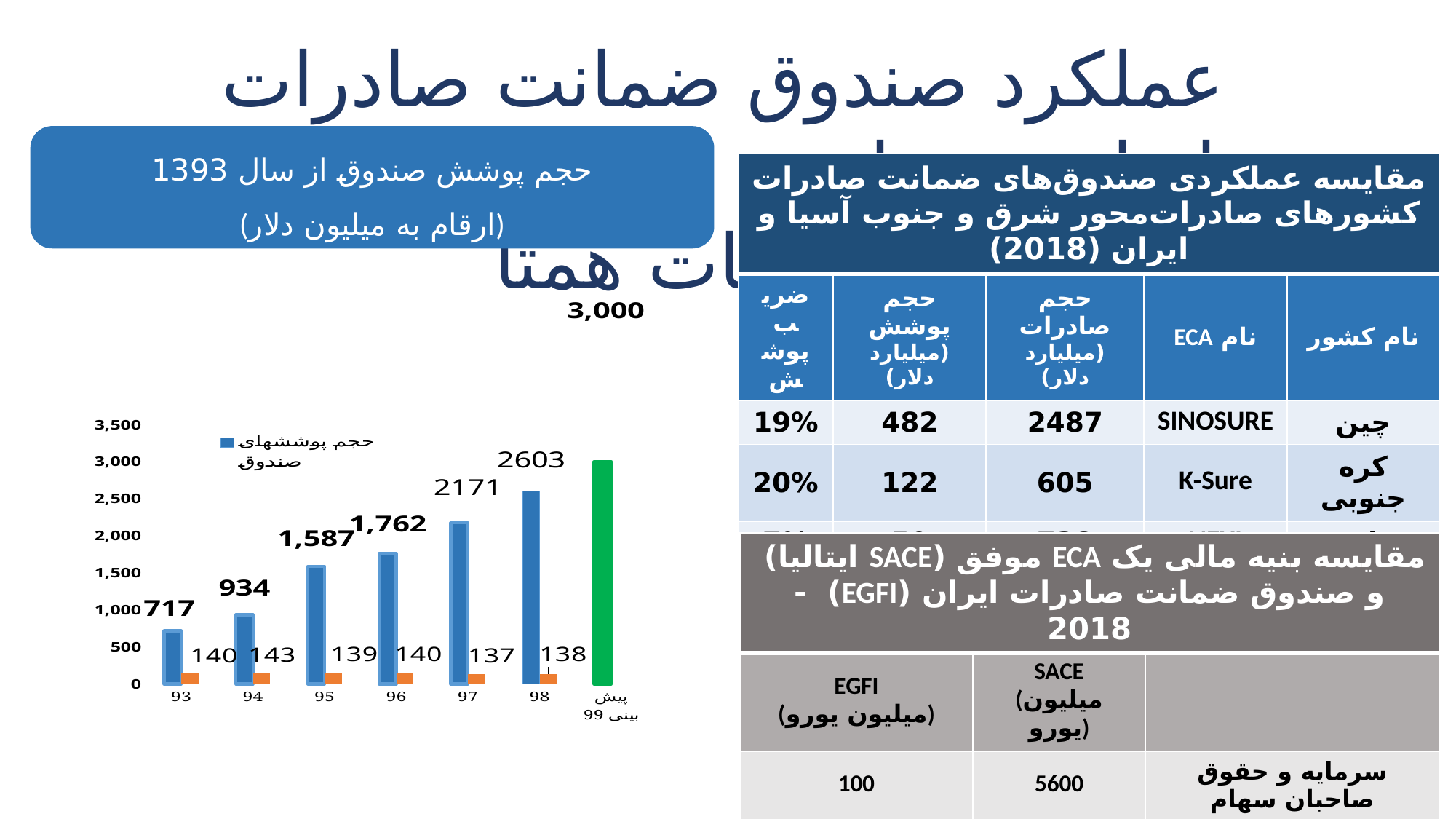
What is the value of the blue bar for year 95? 1,587 What is the value of the blue bar for year 93? 717 What value is shown for the forecast bar (پیش بینی 99)? 3,000 Which year has the larger blue bar, 94 or 96? 96 What is the difference between the blue bar values for 98 and 97? 432 What is the value of the blue bar for year 98? 2603 Do the blue bar values rise or fall from year 93 to year 98? rise What kind of chart is shown on the slide? bar chart Which year has the lowest blue bar? 93 Which category has the highest bar in the chart? پیش بینی 99 What is the difference between the blue bar values for 94 and 93? 217 How many categories are shown on the x axis of the chart? 7